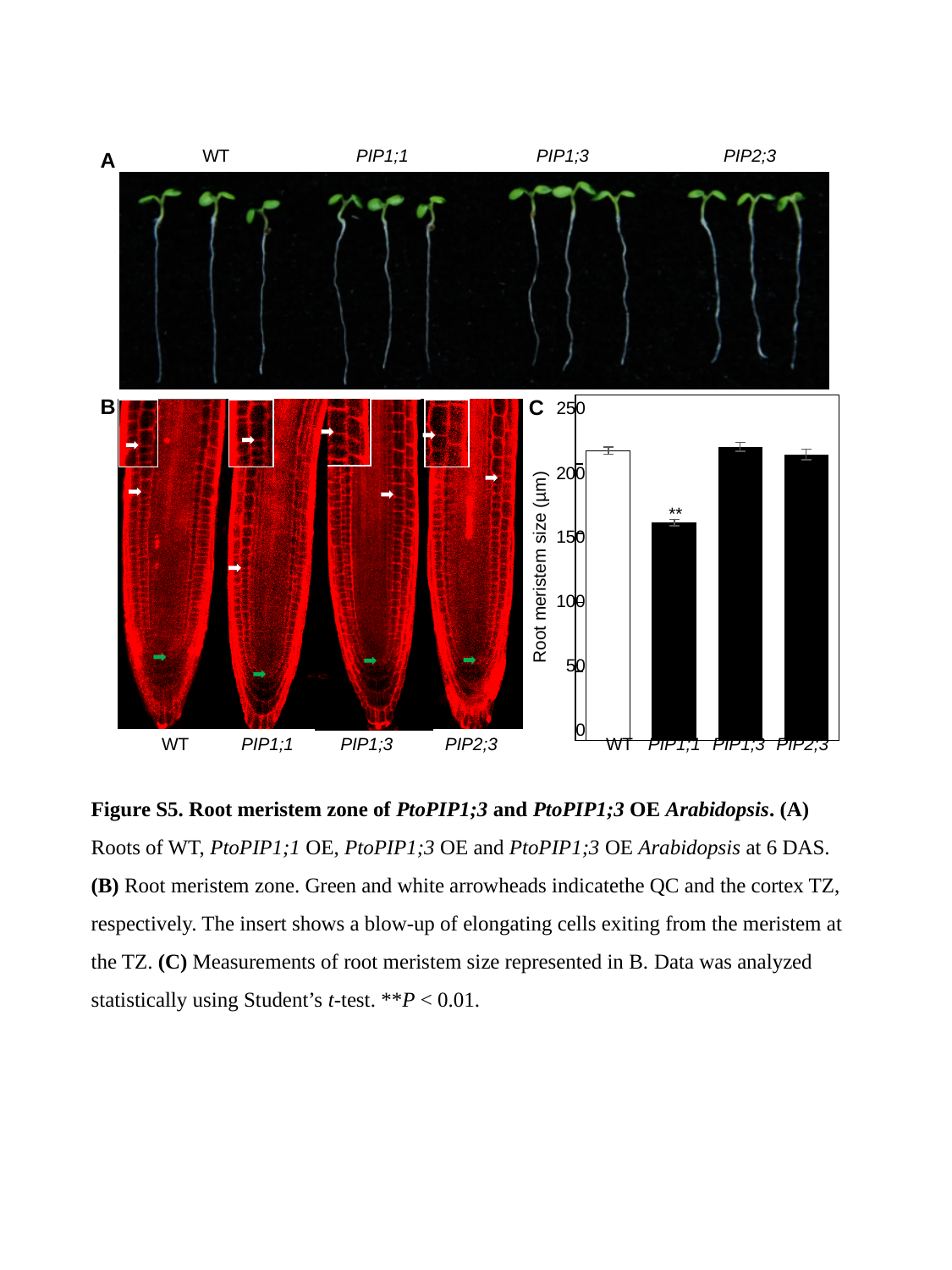
In the bar chart in panel C, which is larger, the value for WT or the value for PIP1;1? WT In the bar chart in panel C, which bar is marked with ** for statistical significance? PIP1;1 What kind of chart is panel C? bar chart In the bar chart in panel C, is the value for WT greater or less than 200? greater How many categories are plotted in the bar chart in panel C? 4 In the bar chart in panel C, which is larger, the value for PIP1;1 or the value for PIP2;3? PIP2;3 In the bar chart in panel C, which category has the lowest root meristem size? PIP1;1 In the bar chart in panel C, is the value for PIP1;3 greater or less than 200? greater In the bar chart in panel C, is the value for PIP1;1 greater or less than 150? greater What is the y-axis label of the bar chart in panel C? Root meristem size (µm)